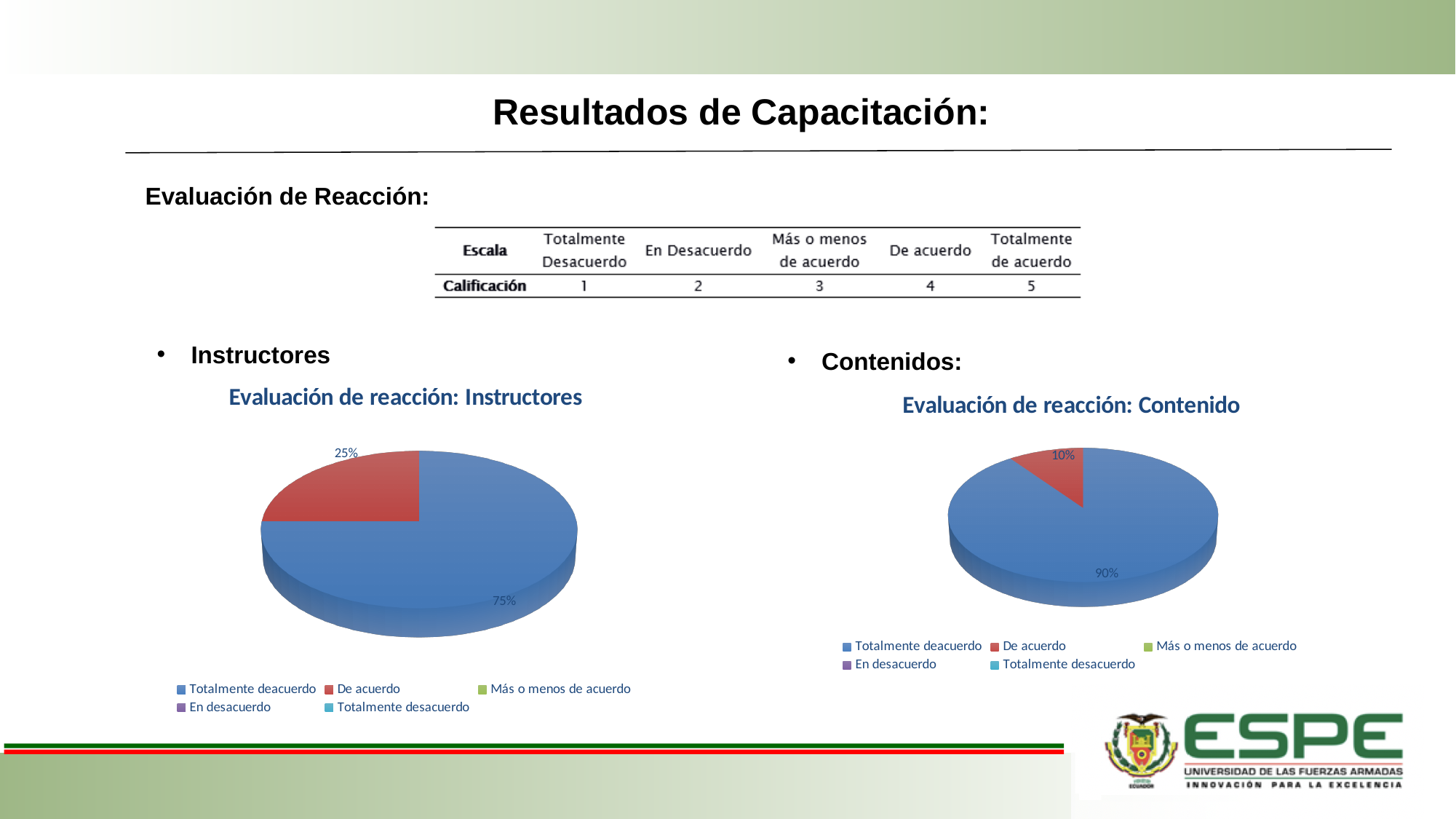
In the chart titled 'Evaluación de reacción: Instructores', what is the difference between the 'Totalmente deacuerdo' and 'De acuerdo' shares? 50% In the chart titled 'Evaluación de reacción: Contenido', which category has the smallest visible slice? De acuerdo In the chart titled 'Evaluación de reacción: Contenido', what colour is the 'Totalmente deacuerdo' slice? Blue In the chart titled 'Evaluación de reacción: Contenido', what share of the pie is 'Totalmente deacuerdo'? 90% In the chart titled 'Evaluación de reacción: Instructores', what share of the pie is 'De acuerdo'? 25% What kind of chart is 'Evaluación de reacción: Contenido'? Pie chart In the chart titled 'Evaluación de reacción: Contenido', what share of the pie is 'De acuerdo'? 10% Which chart has the larger 'De acuerdo' share, 'Evaluación de reacción: Instructores' or 'Evaluación de reacción: Contenido'? Evaluación de reacción: Instructores How many entries does the legend of the chart titled 'Evaluación de reacción: Instructores' list? 5 In the chart titled 'Evaluación de reacción: Contenido', what is the difference between the 'Totalmente deacuerdo' and 'De acuerdo' shares? 80% In the chart titled 'Evaluación de reacción: Instructores', which category has the largest slice? Totalmente deacuerdo